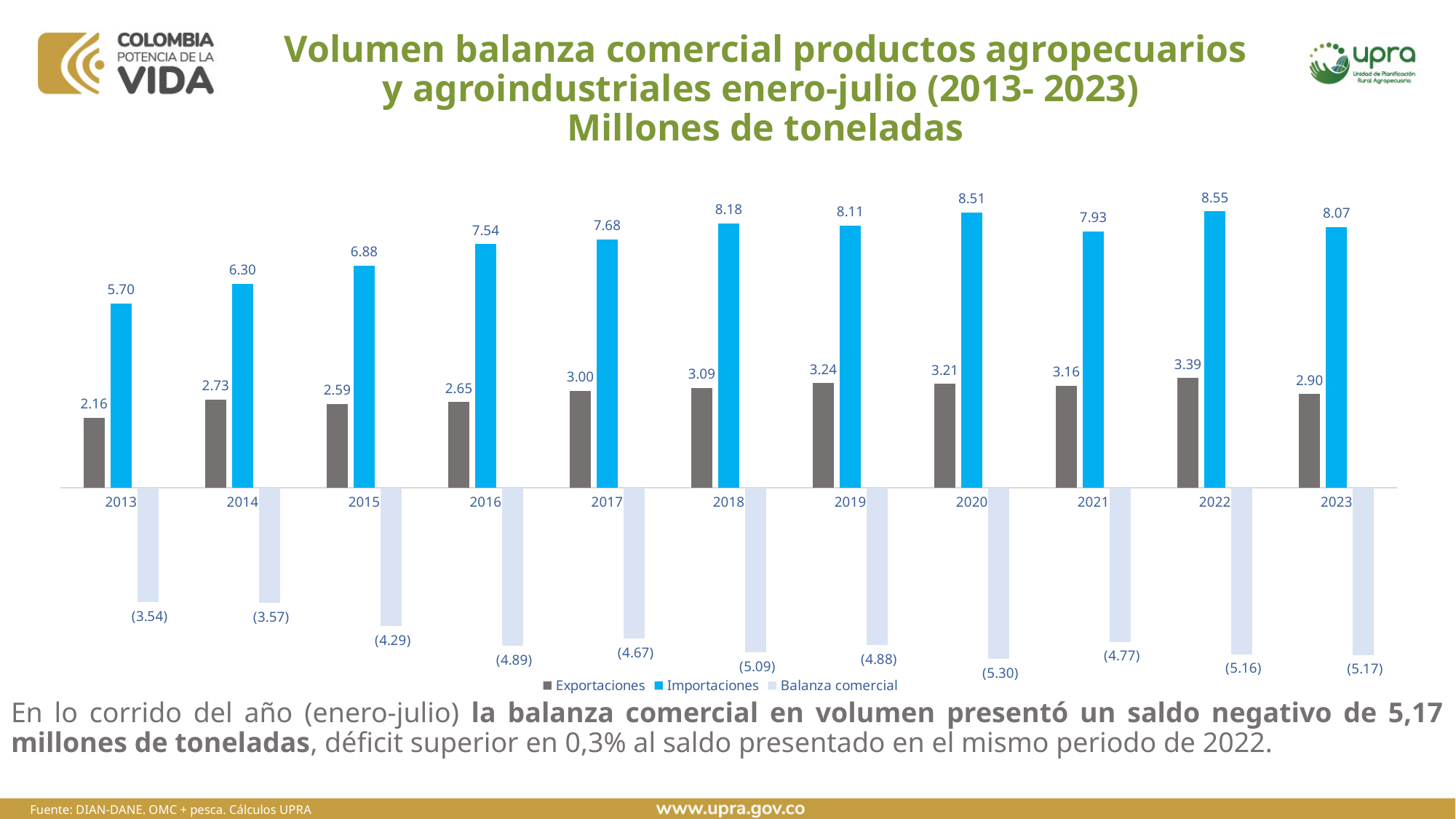
What is the difference between Importaciones and Exportaciones in 2022? 5.16 How many series does the legend list? 3 What is the value of Balanza comercial in 2023? (5.17) Which series is shown in light blue bars? Balanza comercial What kind of chart is shown on the slide? Bar chart What is the value of Exportaciones in 2013? 2.16 Which year has the highest Importaciones value? 2022 How many years are shown on the x axis? 11 Which is larger, Exportaciones in 2019 or Exportaciones in 2021? Exportaciones in 2019 What is the value of Importaciones in 2020? 8.51 Do the Importaciones values generally rise or fall from 2013 to 2018? Rise Which year has the lowest Exportaciones value? 2013